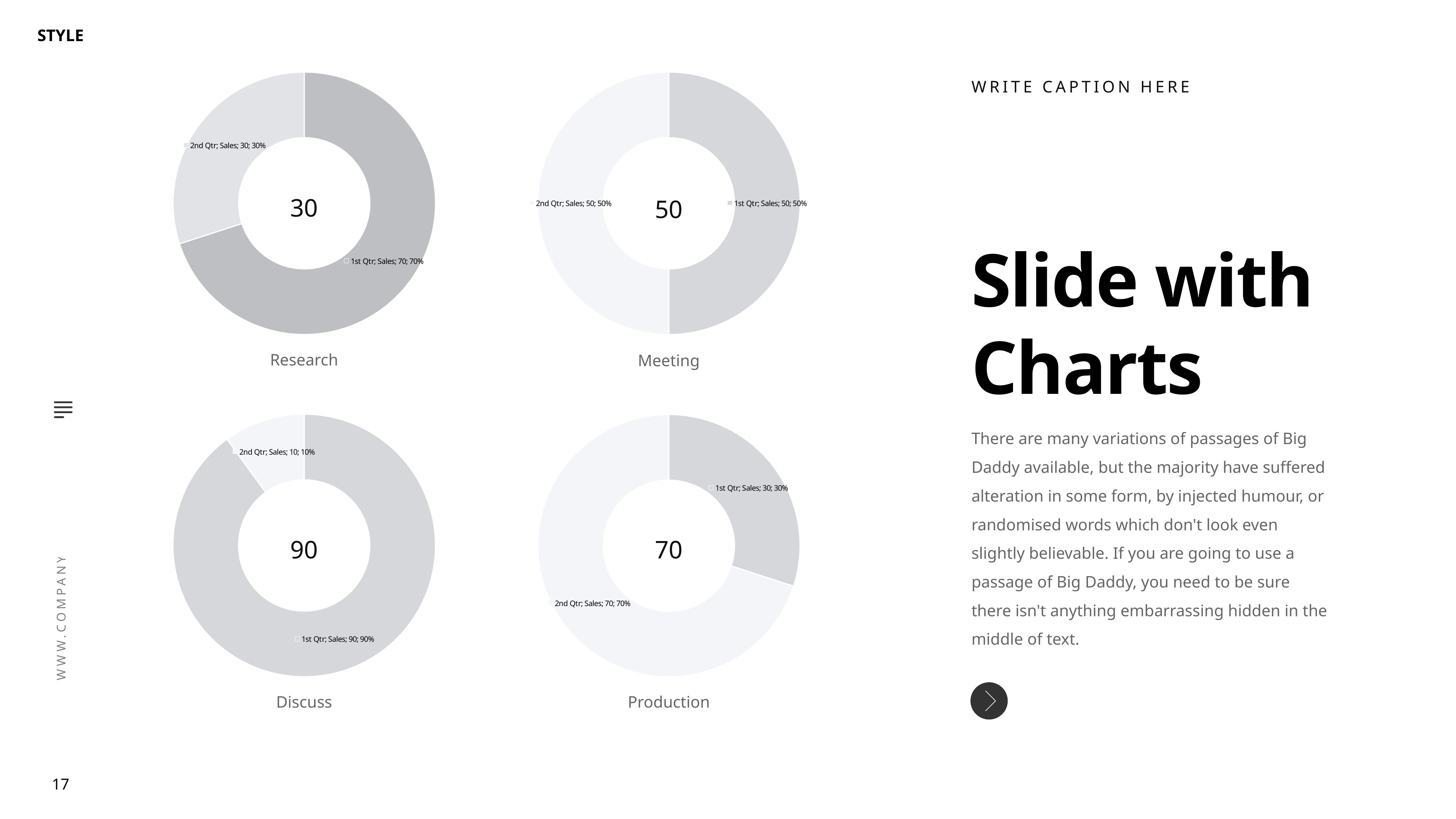
In the Production chart, what share of the total does 2nd Qtr represent? 70% In the Discuss chart, what is the difference between the 1st Qtr and 2nd Qtr values? 80 In the Research chart, which is larger, 1st Qtr or 2nd Qtr? 1st Qtr In the Discuss chart, what is the value for 2nd Qtr? 10 What kind of chart is the Production chart? Doughnut chart In the Research chart, what is the value for 1st Qtr? 70 How many slices does the Meeting chart have? 2 In the Production chart, which quarter has the smallest slice? 1st Qtr In the Discuss chart, which quarter has the largest slice? 1st Qtr In the Meeting chart, what is the value for 2nd Qtr? 50 What number is shown in the centre of the Discuss chart? 90 In the Research chart, what share of the total does 2nd Qtr represent? 30%